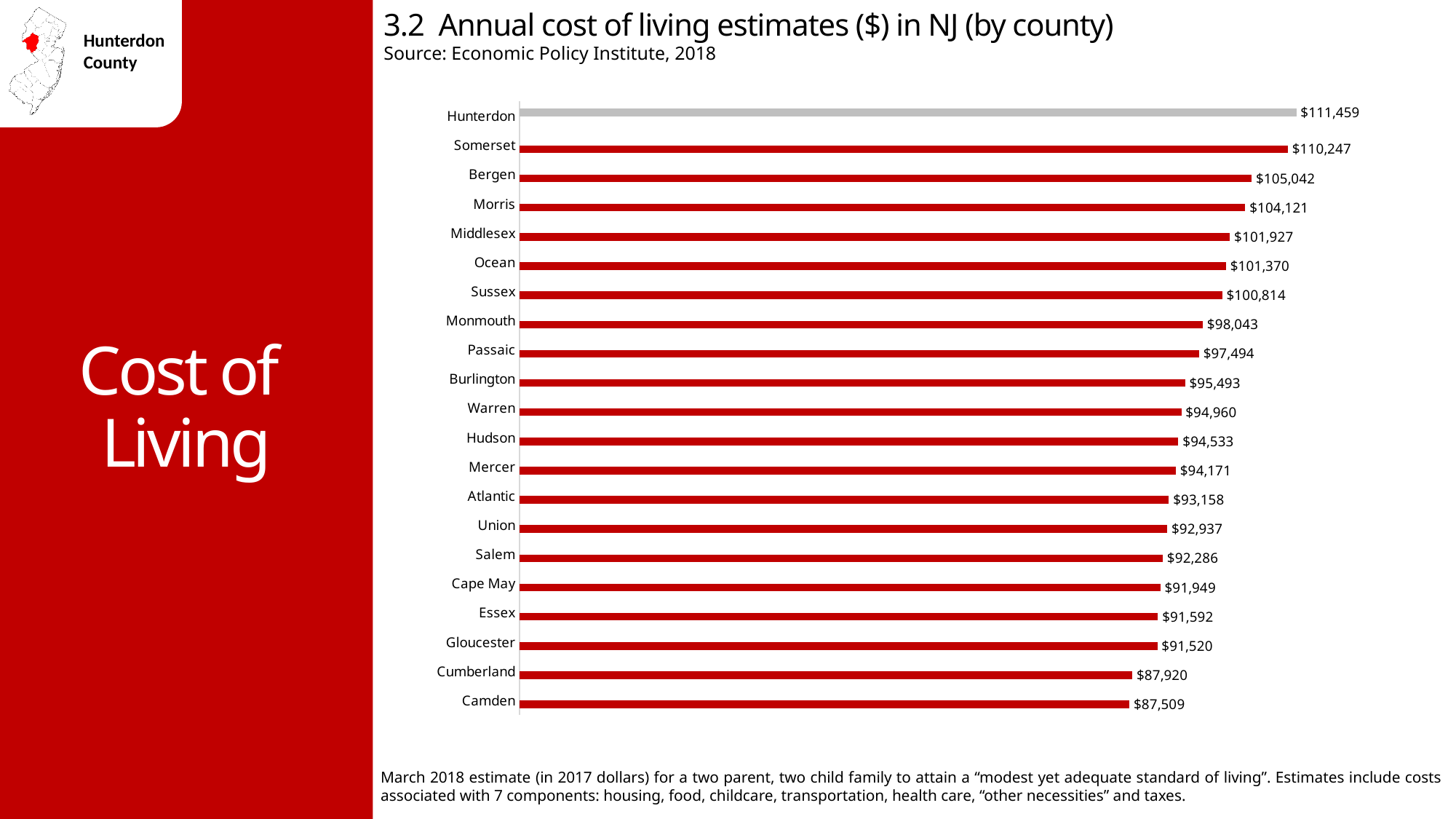
What is the difference between the cost of living estimates for Hunterdon and Somerset counties? $1,212 What is the annual cost of living estimate for Cape May County? $91,949 Which county's bar is shown in a different colour (grey) from the others? Hunterdon Which county has the highest annual cost of living estimate? Hunterdon How many counties are shown in the chart? 21 What is the annual cost of living estimate for Morris County? $104,121 Which county has the lowest annual cost of living estimate? Camden What is the annual cost of living estimate for Hunterdon County? $111,459 What is the difference between the cost of living estimates for Hunterdon and Camden counties? $23,950 Which county has a higher cost of living estimate, Bergen or Ocean? Bergen What type of chart is used to show the cost of living estimates? Bar chart What is the source of the data shown in the chart? Economic Policy Institute, 2018